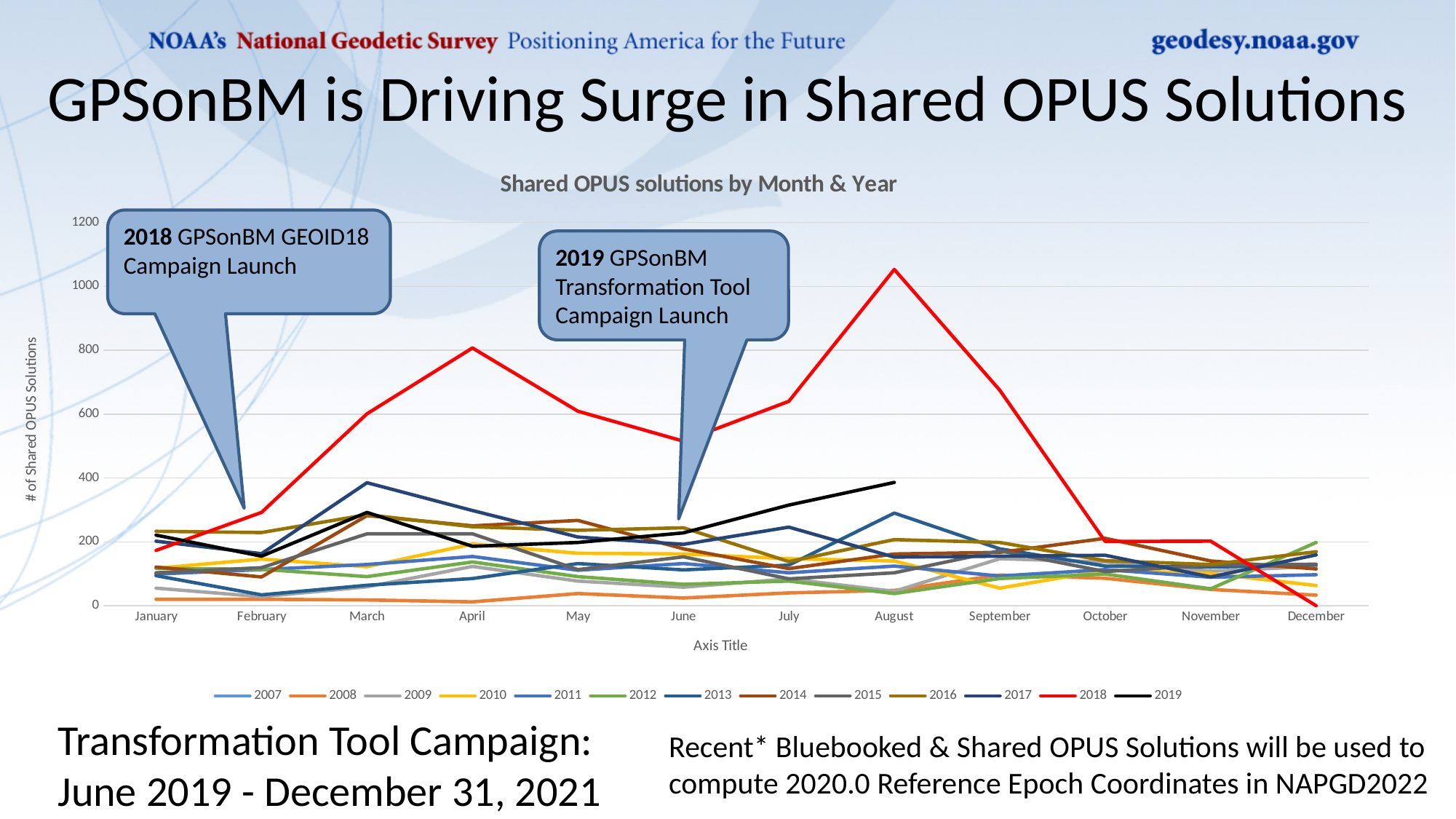
How many months are shown along the x axis? 12 What colour is the line for the 2018 series? red What is the title of the chart? Shared OPUS solutions by Month & Year Is the value for 2018 in August greater or less than 1000? greater Is the value for 2018 in December greater or less than 200? less Is the value for 2018 in June greater or less than 400? greater Which is larger for the 2018 series: the value in April or the value in August? August In which month does the 2018 series reach its lowest value? December Does the 2018 series rise or fall from August to December? fall What kind of chart is shown on the slide? line chart In which month does the 2018 series reach its highest value? August How many series does the legend list? 13